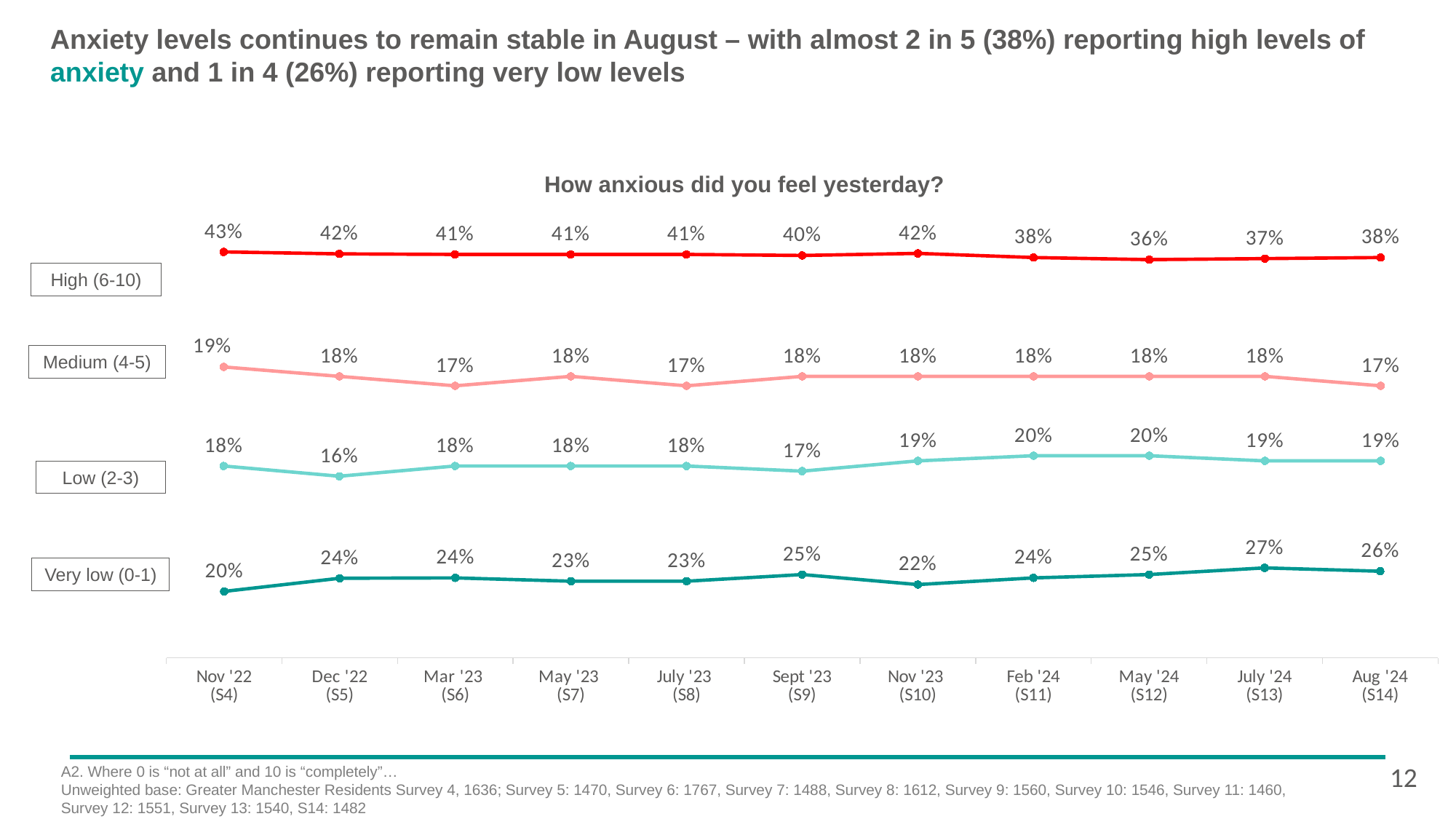
What is the value for High (6-10) in Aug '24 (S14)? 38% What is the value for Medium (4-5) in July '23 (S8)? 17% In which survey wave is the High (6-10) series at its highest? Nov '22 (S4) In which survey wave is the Very low (0-1) series at its highest? July '24 (S13) Which is larger in Aug '24 (S14): the Very low (0-1) value or the Low (2-3) value? Very low (0-1) What is the value for Low (2-3) in Dec '22 (S5)? 16% In which survey wave is the High (6-10) series at its lowest? May '24 (S12) How many survey waves are shown on the x axis? 11 What type of chart is shown? Line chart What is the difference between the High (6-10) value in Nov '22 (S4) and in Aug '24 (S14)? 5 percentage points What is the value for Very low (0-1) in Nov '22 (S4)? 20% How many series are plotted on the chart? 4